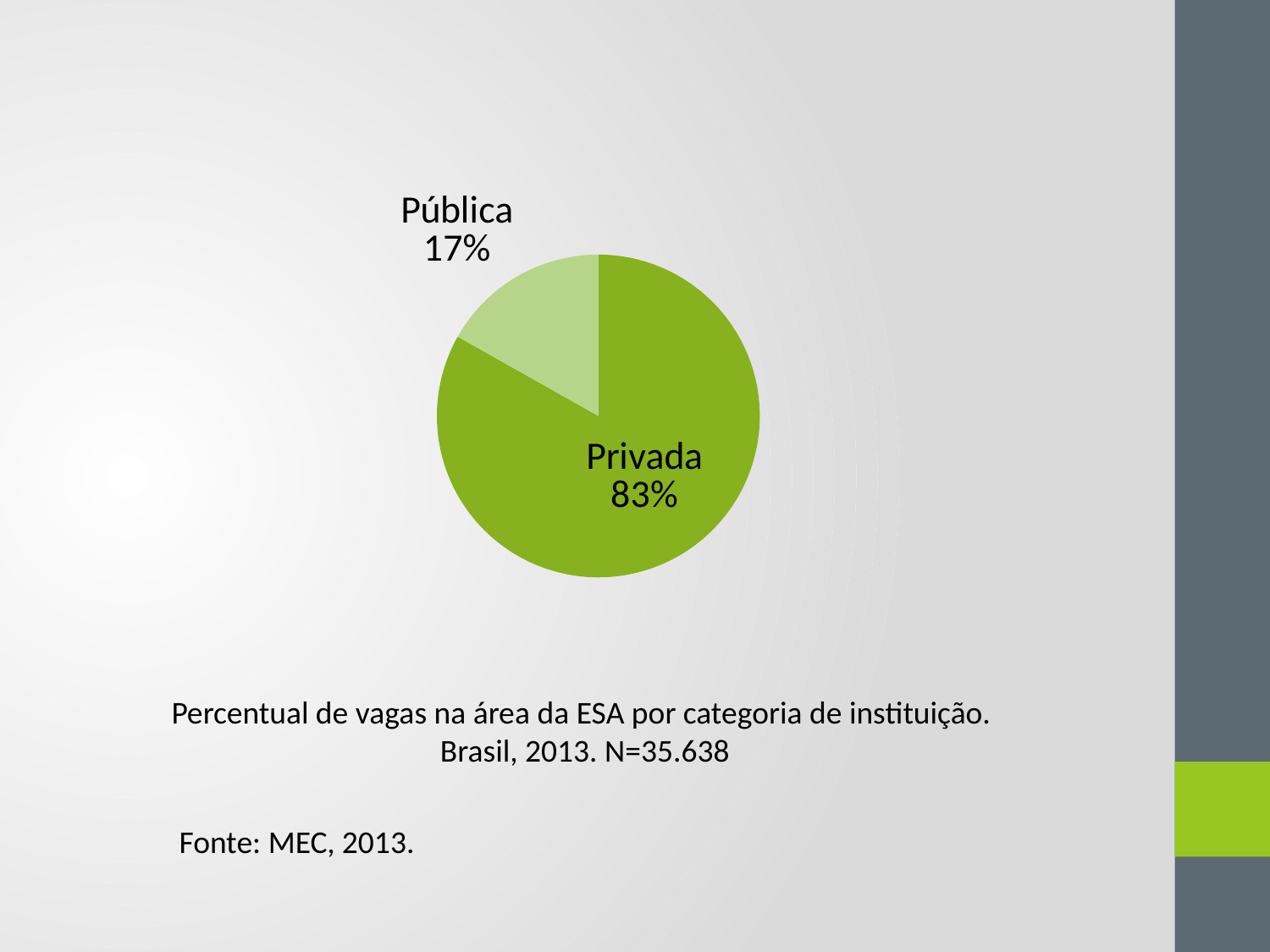
What kind of chart is shown on the slide? Pie chart Which category has the smallest slice of the pie chart? Pública How many slices does the pie chart have? 2 What is the difference in percentage points between the Privada and Pública slices? 66 What percentage of the pie chart is labelled Pública? 17% What source is cited for the chart? MEC, 2013. What percentage of the pie chart is labelled Privada? 83% What share of the pie does the Pública slice represent? 17% What is the N value stated in the chart caption? 35.638 Which category has the largest slice of the pie chart? Privada Which slice is larger, Privada or Pública? Privada